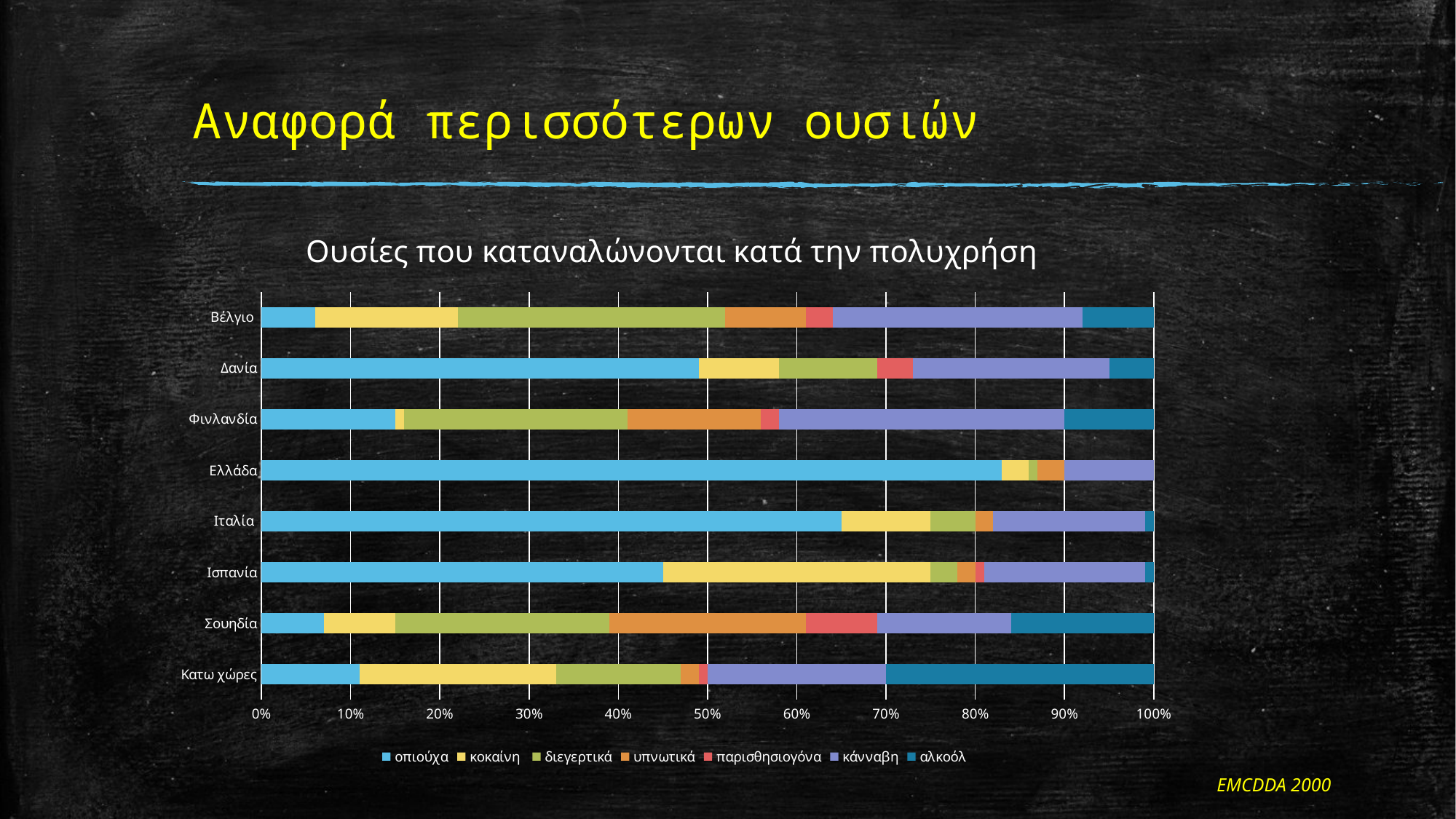
Which is larger, the share for οπιούχα in Ελλάδα or in Ιταλία? Ελλάδα Which country has the largest share for οπιούχα? Ελλάδα Is the share for οπιούχα in Βέλγιο greater or less than 10%? less Which country has the largest share for αλκοόλ? Κάτω χώρες How many countries are listed on the vertical axis of the chart? 8 Is the share for οπιούχα in Ιταλία greater or less than 60%? greater How many series does the chart legend list? 7 Is the share for οπιούχα in Ελλάδα greater or less than 80%? greater Which country has the largest share for κοκαΐνη? Ισπανία Which series is listed first in the chart legend? οπιούχα What is the title of the chart? Ουσίες που καταναλώνονται κατά την πολυχρήση What kind of chart is shown on the slide? Stacked bar chart